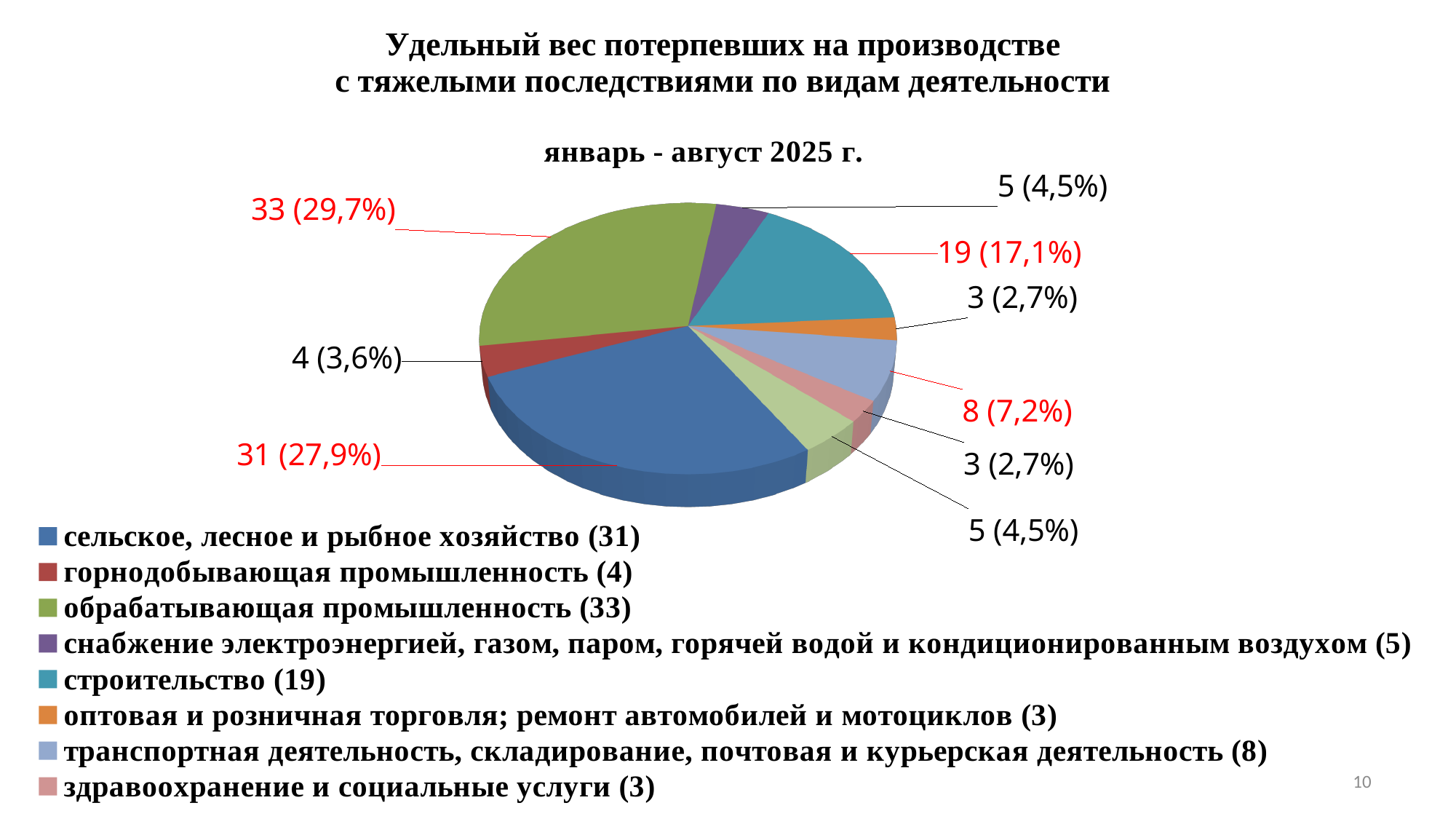
What kind of chart is shown on the slide? pie chart Which is larger, the value for строительство or the value for транспортная деятельность, складирование, почтовая и курьерская деятельность? строительство What share of the pie does обрабатывающая промышленность have? 29,7% How many slices does the pie chart have? 9 Which category has the largest slice? обрабатывающая промышленность What is the difference between the values for обрабатывающая промышленность and сельское, лесное и рыбное хозяйство? 2 What share of the pie does сельское, лесное и рыбное хозяйство have? 27,9% What share of the pie does транспортная деятельность, складирование, почтовая и курьерская деятельность have? 7,2% What is the value for горнодобывающая промышленность? 4 What is the value for строительство? 19 What period does the chart cover according to its title? январь - август 2025 г. What is the difference between the values for строительство and транспортная деятельность, складирование, почтовая и курьерская деятельность? 11